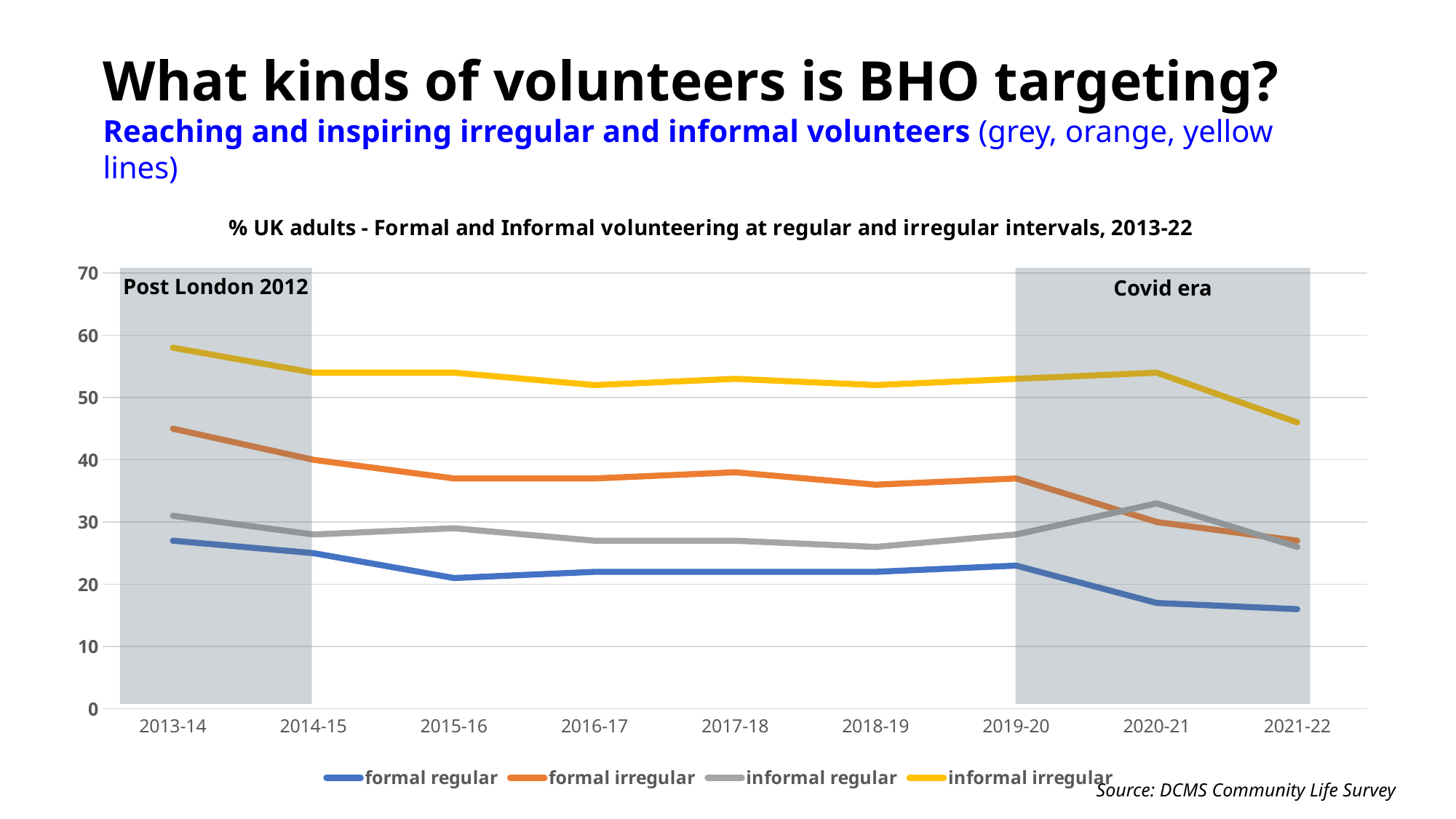
Does the formal regular line rise or fall overall from 2013-14 to 2021-22? fall How many years are shown along the x axis of the chart? 9 Is the value for informal irregular in 2021-22 greater or less than 50? less Which series has the highest values across the whole chart? informal irregular What are the labels of the two shaded regions on the chart? Post London 2012 and Covid era How many series does the chart legend list? 4 Is the value for informal irregular in 2013-14 greater or less than 50? greater Which series has the lowest value in 2021-22? formal regular In 2013-14, which is larger: formal irregular or informal regular? formal irregular Is the value for formal irregular in 2013-14 greater or less than 40? greater What kind of chart is shown on the slide? line chart